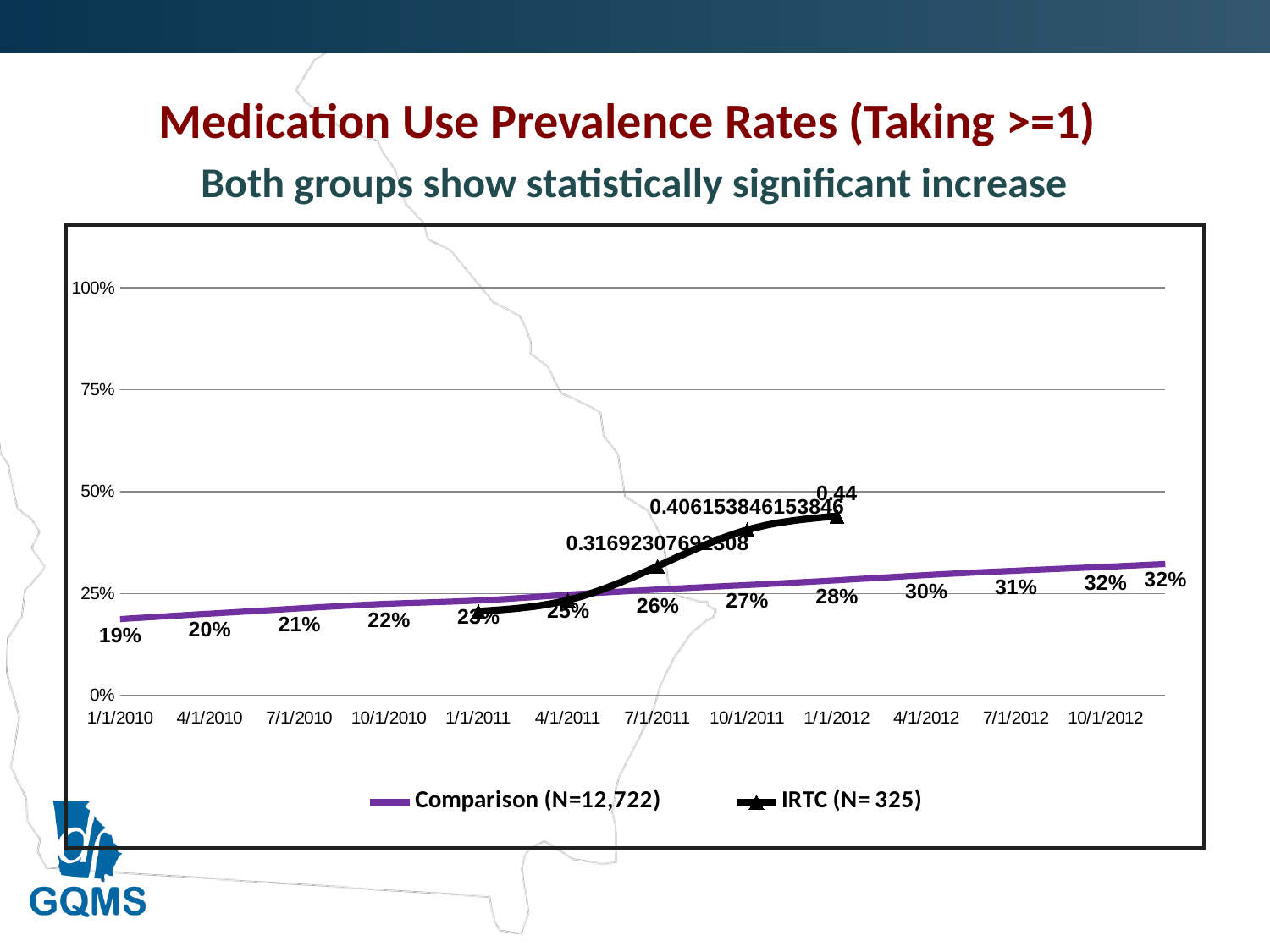
What kind of chart is shown on the slide? line chart What is the IRTC value at 10/1/2011? 0.406153846153846 What is the title of the chart? Medication Use Prevalence Rates (Taking >=1) What is the Comparison value at 4/1/2012? 30% What is the Comparison value at 1/1/2010? 19% What is the IRTC value at 1/1/2012? 0.44 What are the two series named in the legend? Comparison (N=12,722) and IRTC (N= 325) What is the lowest labelled value for the Comparison series? 19% What is the difference between the Comparison value at 10/1/2012 and at 1/1/2010? 13 percentage points How many series does the legend list? 2 At 1/1/2012, which series has the higher value, Comparison or IRTC? IRTC Is the IRTC value at 1/1/2012 greater or less than 50%? less